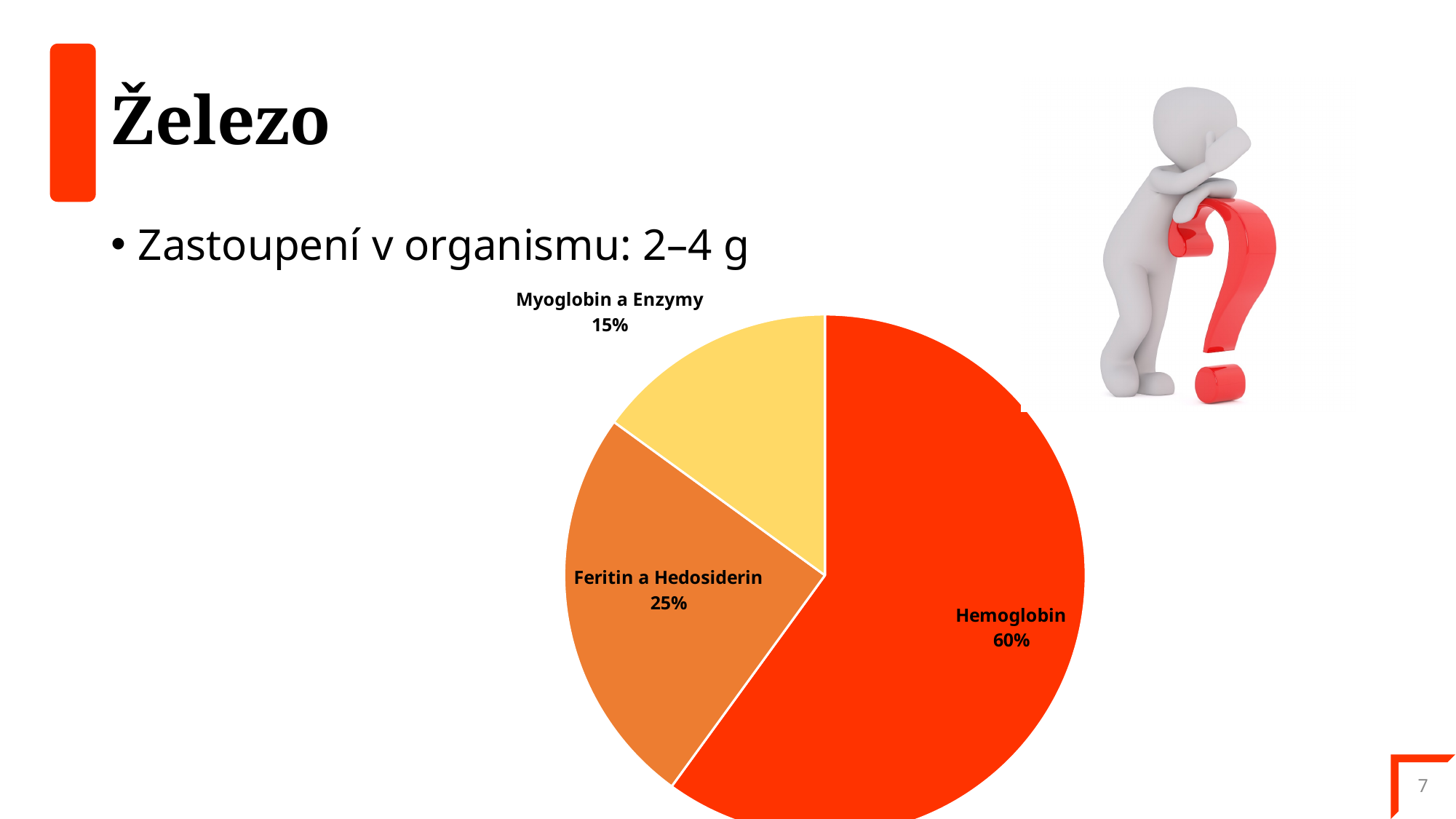
What share of the pie does Myoglobin a Enzymy have? 15% What is the difference between the Hemoglobin share and the Feritin a Hedosiderin share? 35% What share of the pie does Hemoglobin have? 60% Which is larger, the share for Feritin a Hedosiderin or the share for Myoglobin a Enzymy? Feritin a Hedosiderin What kind of chart is shown on the slide? pie chart How many slices does the pie chart have? 3 What is the difference between the Feritin a Hedosiderin share and the Myoglobin a Enzymy share? 10% What share of the pie does Feritin a Hedosiderin have? 25% Which slice of the pie is the largest? Hemoglobin Which slice of the pie is the smallest? Myoglobin a Enzymy What colour is the Hemoglobin slice? red What colour is the Myoglobin a Enzymy slice? yellow